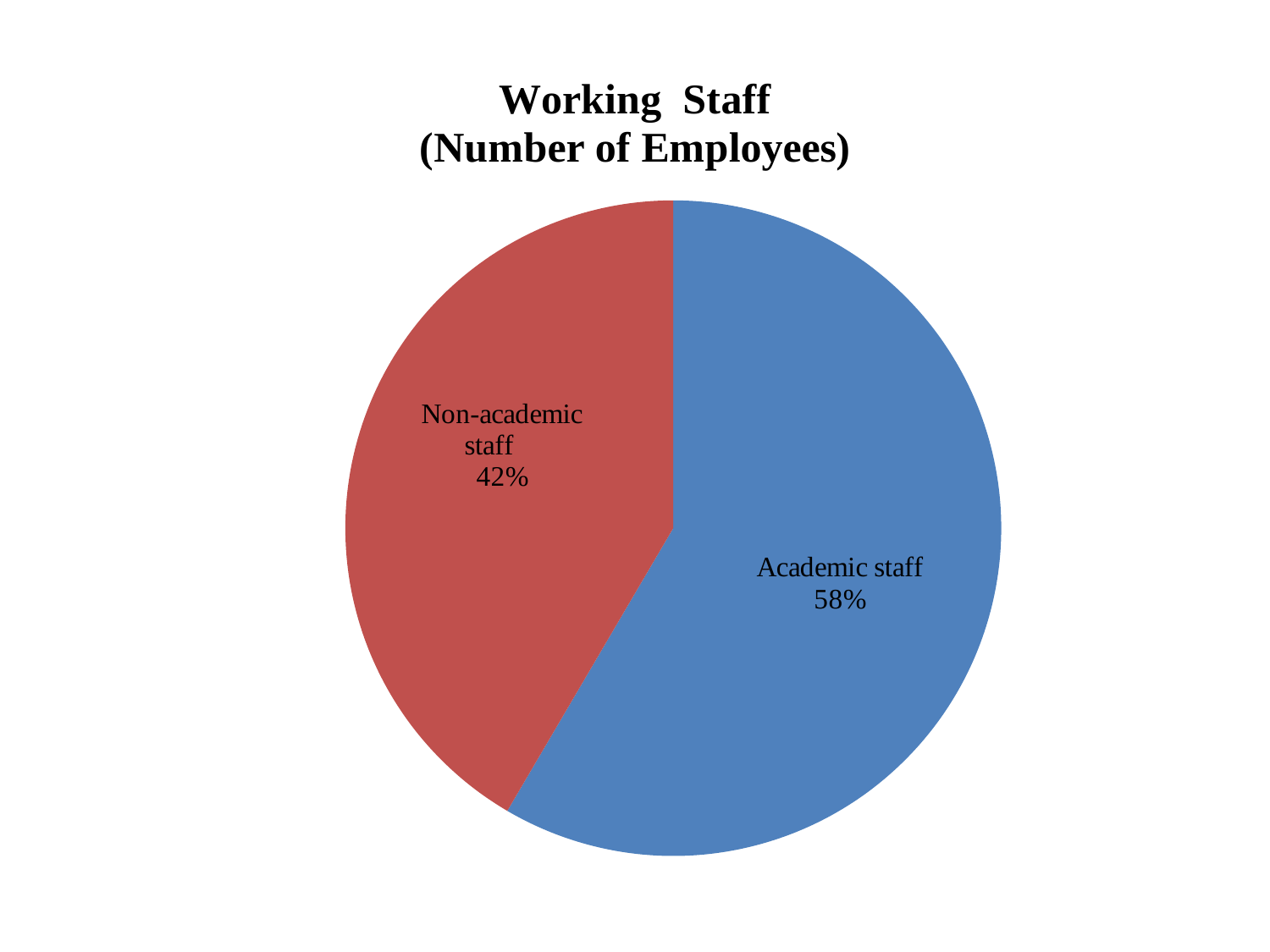
What kind of chart is shown on the slide? Pie chart How many categories are shown in the pie chart? 2 What share of the pie does Non-academic staff represent? 42% Which category has the largest slice of the pie? Academic staff Which slice is larger, Academic staff or Non-academic staff? Academic staff Is the share for Non-academic staff greater or less than 50%? less What share of the pie does Academic staff represent? 58% What colour is the Academic staff slice? Blue Which category has the smallest slice of the pie? Non-academic staff What is the title of the chart? Working Staff (Number of Employees) What is the difference in percentage points between the Academic staff and Non-academic staff slices? 16